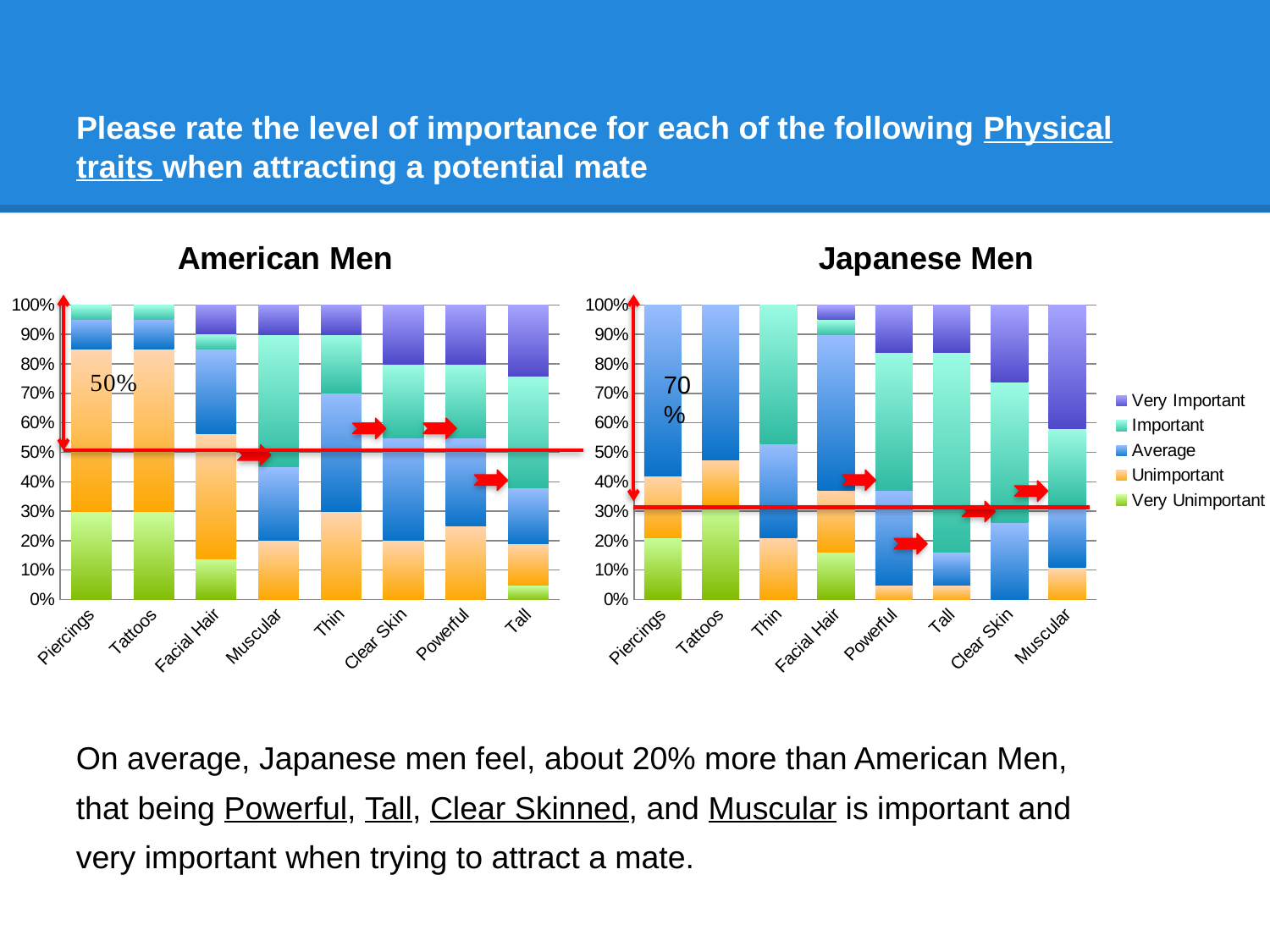
How many series does the legend list? 5 In the Japanese Men chart, is the Very Unimportant value for Tattoos greater or less than 20%? greater In the Japanese Men chart, which category has the largest Very Important segment? Muscular In the American Men chart, which has the larger Very Unimportant value, Piercings or Tall? Piercings In the American Men chart, is the Very Unimportant value for Tall greater or less than 10%? less What are the titles of the two charts on the slide? American Men and Japanese Men Which series is shown in purple in the legend? Very Important In the American Men chart, is the Very Unimportant value for Piercings greater or less than 20%? greater In the Japanese Men chart, which has the larger Very Important value, Muscular or Piercings? Muscular What kind of chart is the American Men chart? Stacked bar chart How many categories are shown on the x axis of the Japanese Men chart? 8